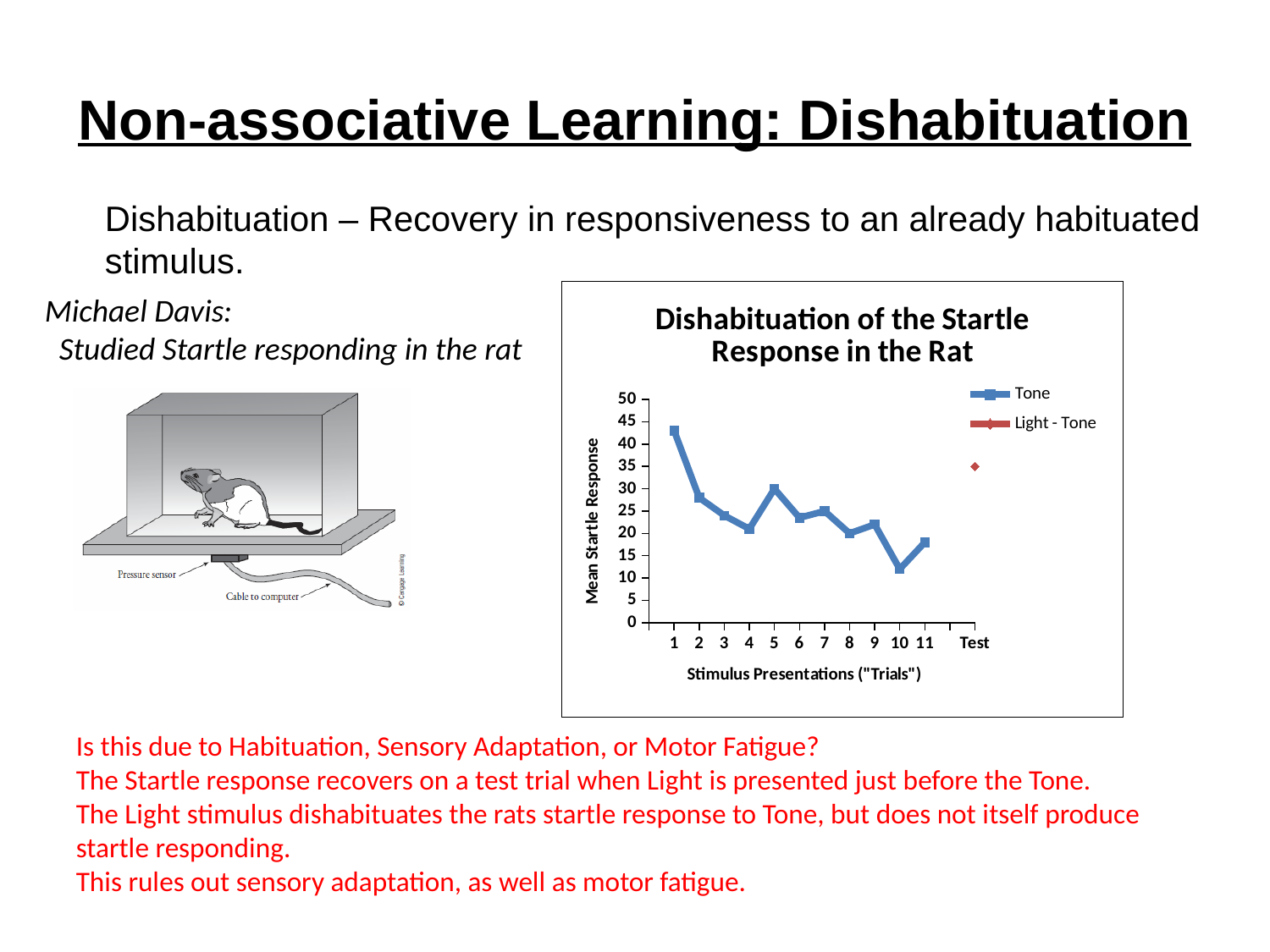
What is the title of the chart? Dishabituation of the Startle Response in the Rat What is the label of the chart's y axis? Mean Startle Response Which is larger for the Tone series: the value at trial 5 or the value at trial 4? trial 5 At which trial is the Tone series lowest? 10 Is the Light - Tone value at Test greater or less than 30? greater Does the Tone series generally rise or fall across trials 1 to 11? fall How many categories are shown along the x axis of the chart? 12 Is the Tone value at trial 1 greater or less than 40? greater What kind of chart is shown on the slide? line chart At which trial is the Tone series highest? 1 How many series does the chart's legend list? 2 Is the Tone value at trial 10 greater or less than 15? less